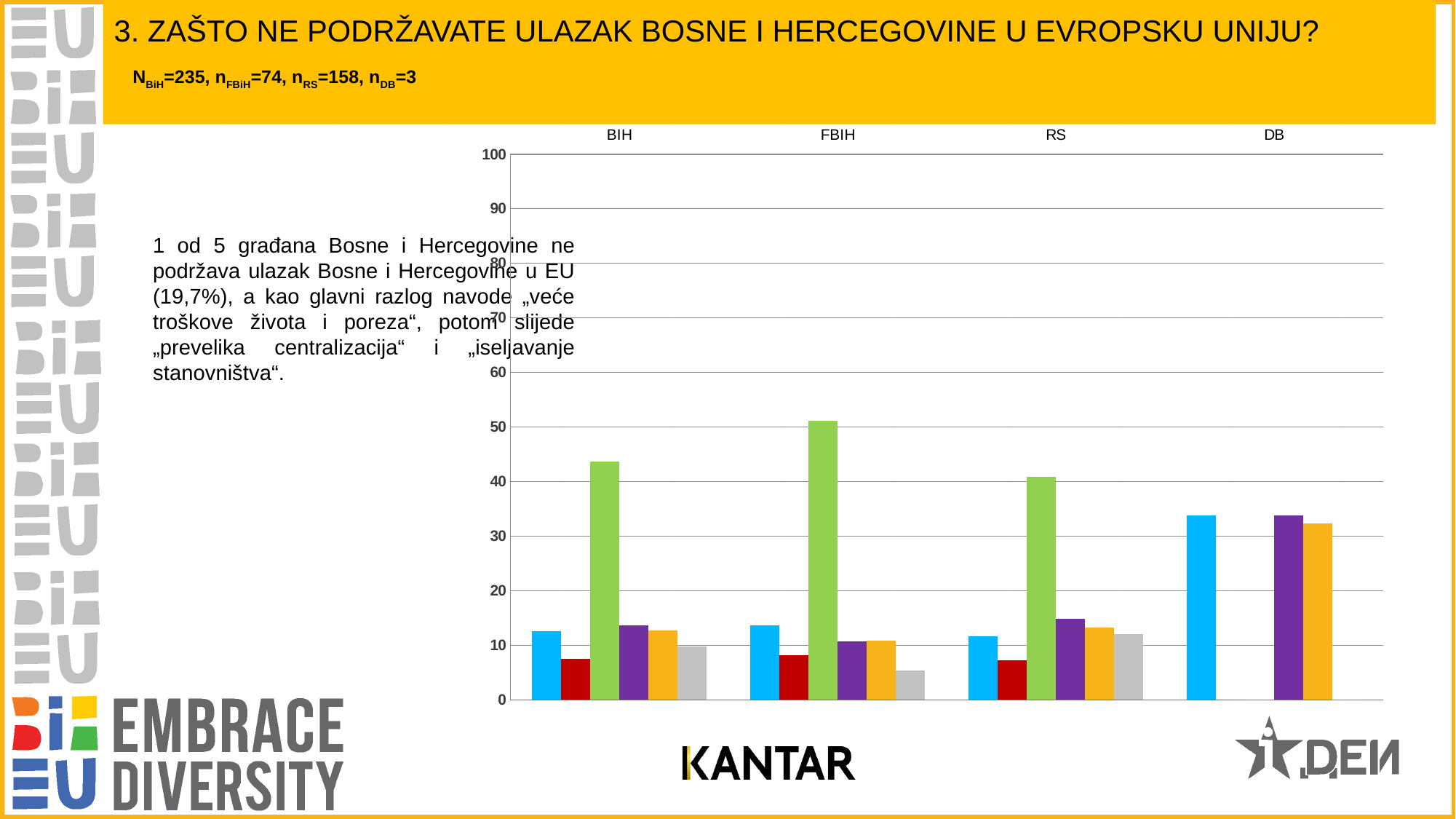
Is the value of the red bar for BIH greater or less than 10? less What kind of chart is shown on the slide? bar chart How many categories are shown along the x axis of the chart? 4 How many bars are plotted for the DB category? 3 Is the value of the grey bar for FBIH greater or less than 10? less What is the maximum value shown on the vertical axis of the chart? 100 Is the value of the green bar for RS greater or less than 30? greater For BIH, which is larger: the green bar or the light blue bar? the green bar Which category has the tallest green bar? FBIH